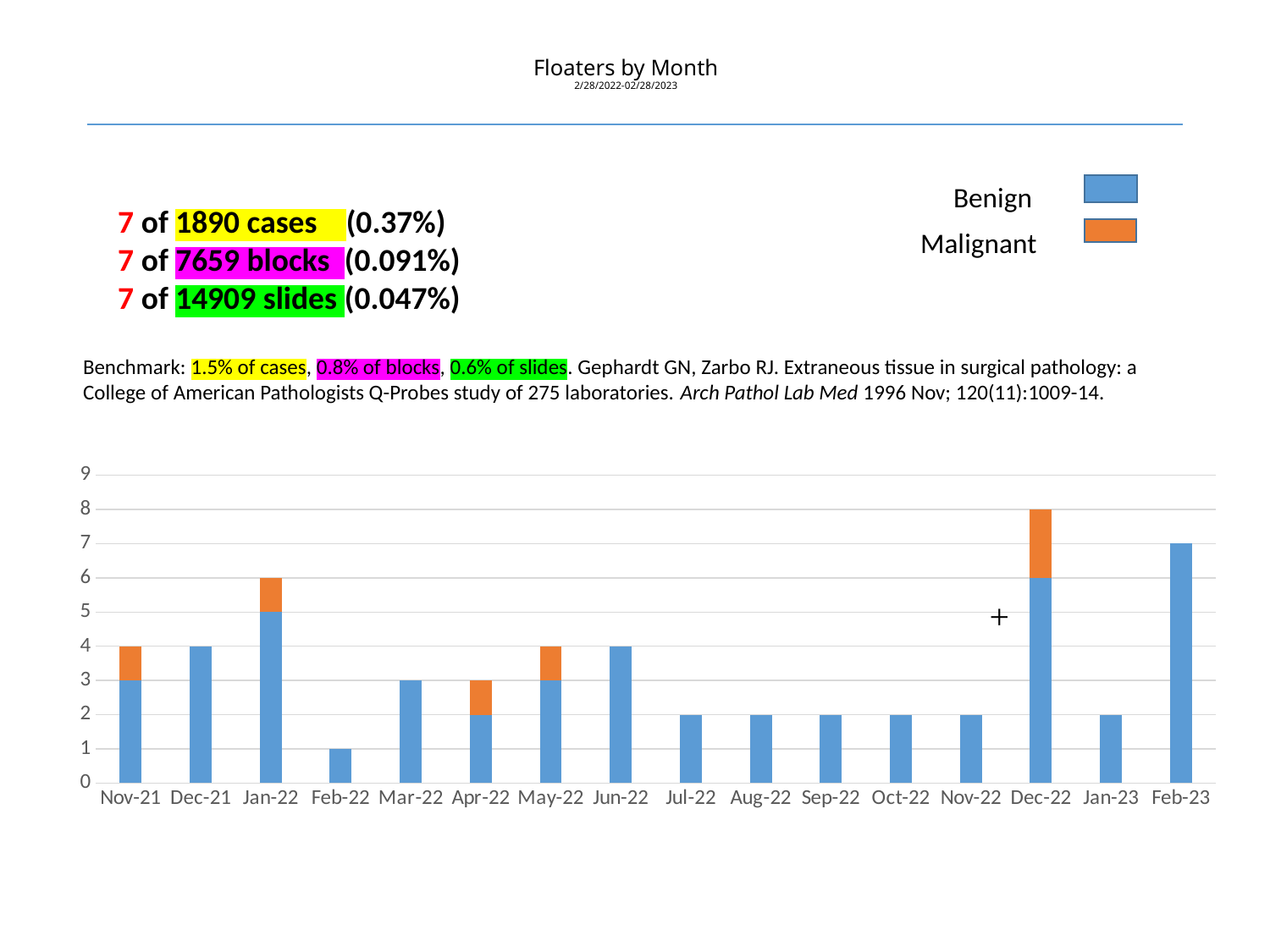
What is the difference between the total bar for Dec-22 and the bar for Feb-23? 1 Is the total bar for Dec-22 greater or less than 7? greater What is the total height of the bar for Dec-22? 8 What is the Benign value for Jan-22? 5 How many months are shown along the x axis? 16 Which month has the lowest total bar? Feb-22 How many series does the legend list? 2 Which month has the highest total bar? Dec-22 What is the value of the bar for Feb-23? 7 What kind of chart is shown on the slide? stacked bar chart Which is larger, the bar for Jun-22 or the bar for Jul-22? Jun-22 Which colour represents Malignant in the legend? orange